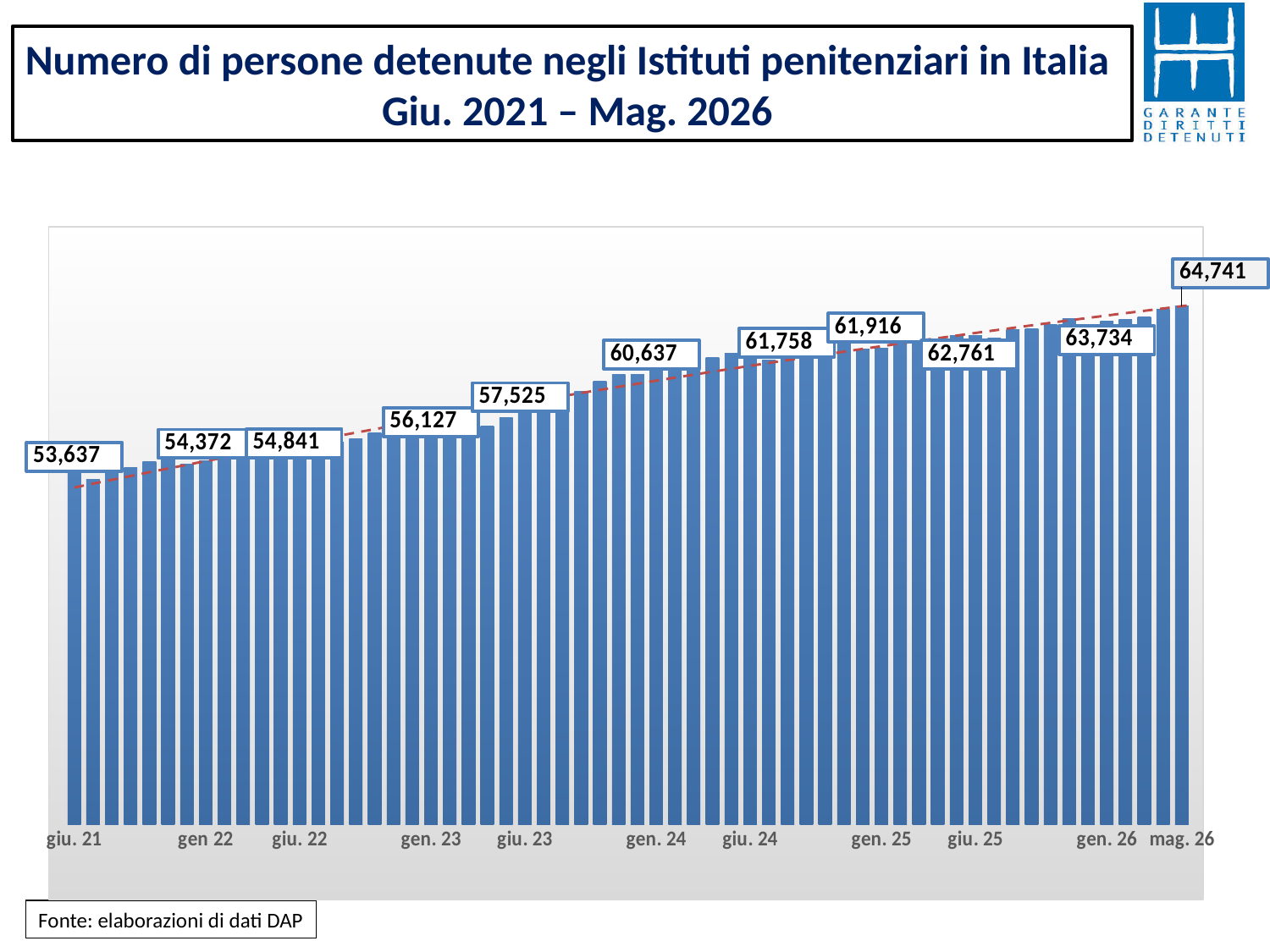
What is the value labelled for giu. 21? 53,637 What source is cited for the chart data? Fonte: elaborazioni di dati DAP What is the difference between the value for mag. 26 and the value for giu. 21? 11,104 What is the title of the chart on the slide? Numero di persone detenute negli Istituti penitenziari in Italia Giu. 2021 – Mag. 2026 Which is larger, the value for gen. 25 or the value for giu. 24? gen. 25 What is the value labelled for gen. 24? 60,637 What kind of chart is shown on the slide? bar chart Do the values generally rise or fall from giu. 21 to mag. 26? rise What is the value labelled for mag. 26? 64,741 Which labelled point has the highest value? mag. 26 Which labelled point has the lowest value? giu. 21